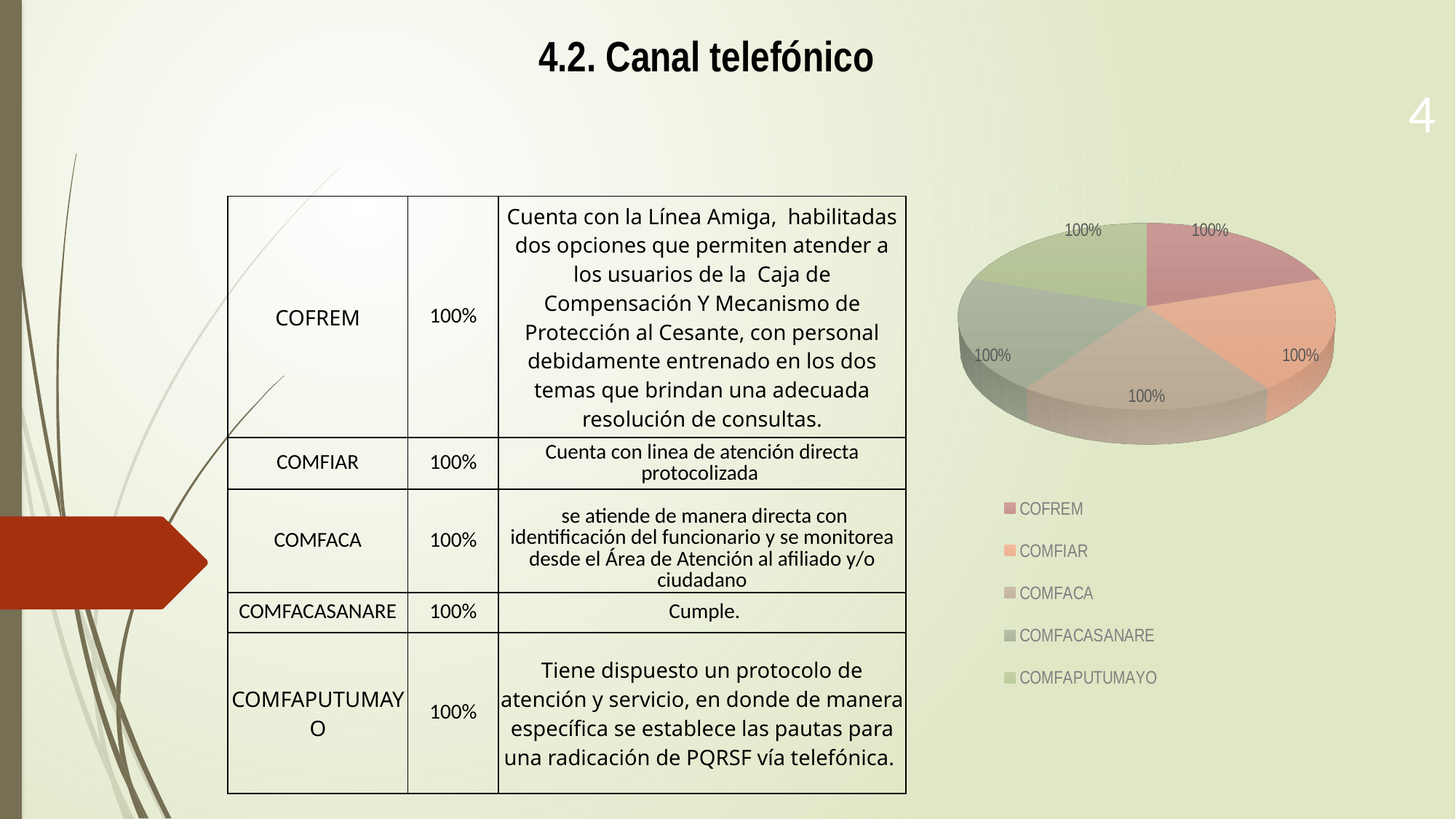
What value is labelled on the COMFACASANARE slice of the pie chart? 100% What value is labelled on the COFREM slice of the pie chart? 100% How many entries does the pie chart's legend list? 5 Which entry is listed last in the pie chart's legend? COMFAPUTUMAYO What value is labelled on the COMFAPUTUMAYO slice of the pie chart? 100% What is the difference between the values labelled for COFREM and COMFIAR in the pie chart? 0% Which entry is listed first in the pie chart's legend? COFREM What value is labelled on the COMFIAR slice of the pie chart? 100% What value is labelled on the COMFACA slice of the pie chart? 100% What kind of chart is shown on the right side of the slide? pie chart How many slices does the pie chart have? 5